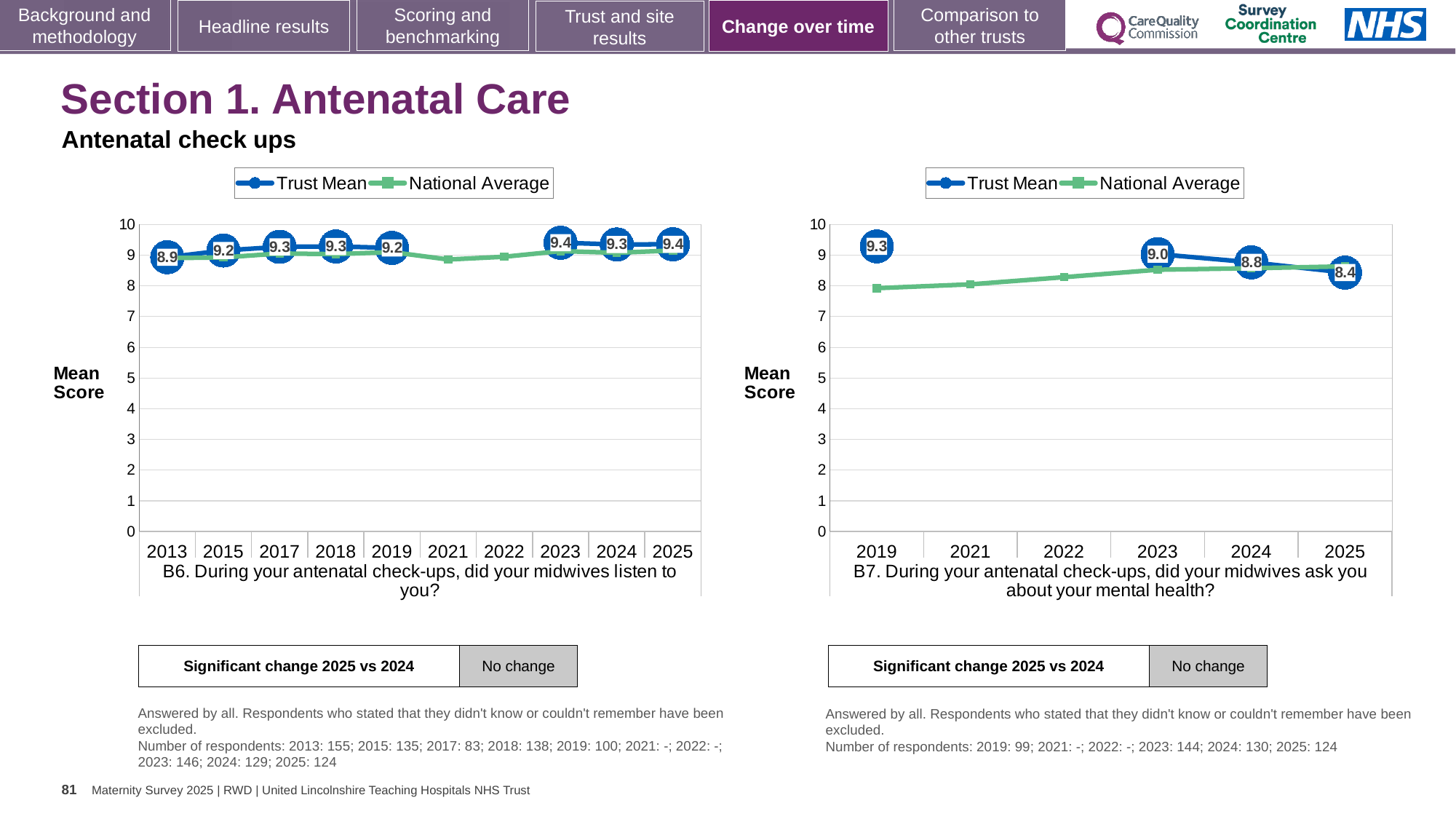
In the B6 chart (left), what is the Trust Mean for 2013? 8.9 How many series does the legend of the B6 chart (left) list? 2 In the B6 chart (left), which year has the lowest labelled Trust Mean? 2013 In the B7 chart (right), which is larger: the Trust Mean for 2023 or the Trust Mean for 2024? 2023 In the B7 chart (right), what is the difference between the Trust Mean for 2019 and the Trust Mean for 2025? 0.9 In the B6 chart (left), what is the Trust Mean for 2025? 9.4 In the B7 chart (right), which year has the lowest labelled Trust Mean? 2025 In the B7 chart (right), what is the Trust Mean for 2019? 9.3 In the B7 chart (right), is the National Average for 2019 greater or less than 9? less What type of chart is the B6 chart (left)? Line chart In the B7 chart (right), what is the Trust Mean for 2025? 8.4 How many years are shown on the x axis of the B7 chart (right)? 6